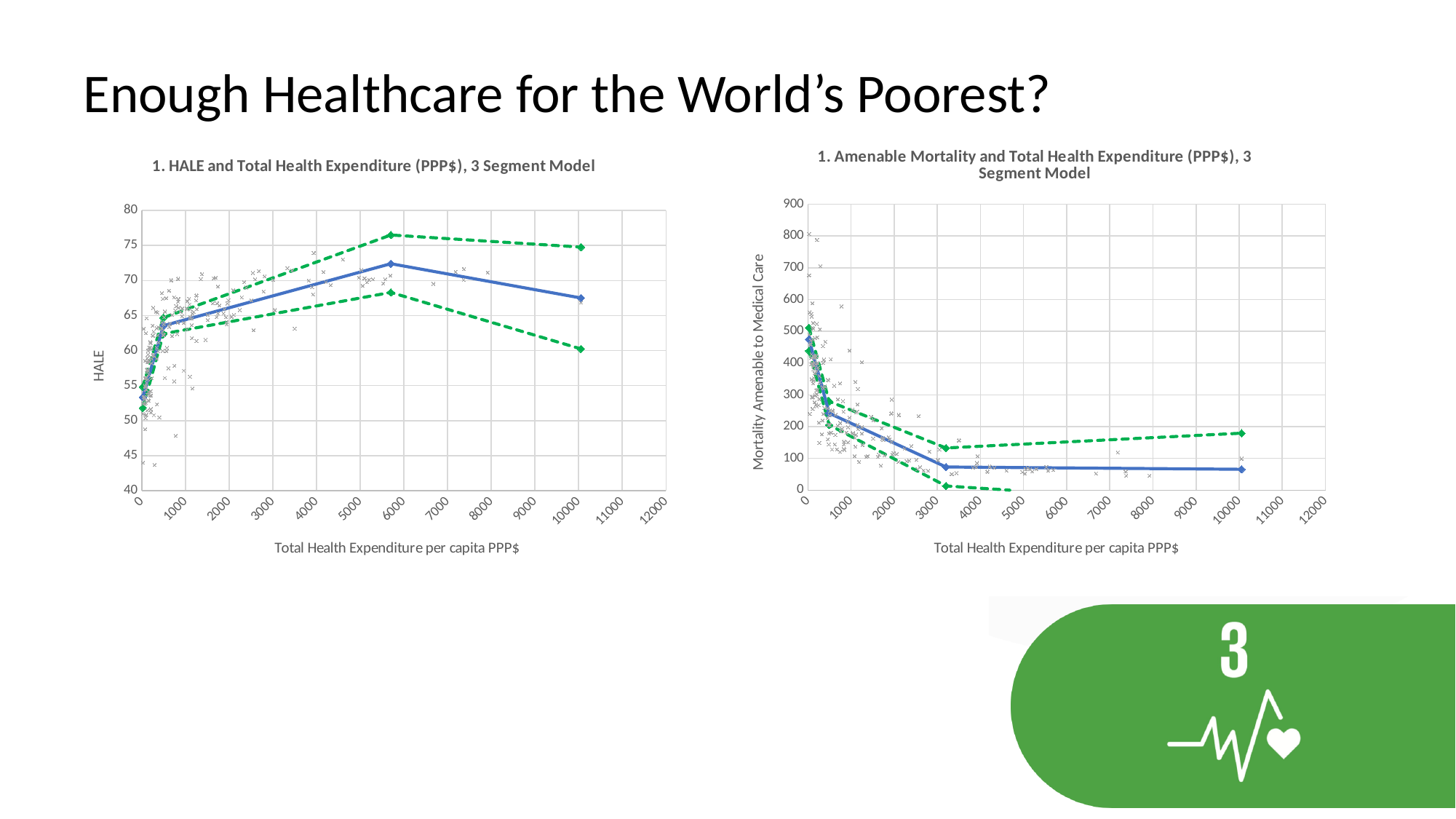
What is the title of the chart on the left? 1. HALE and Total Health Expenditure (PPP$), 3 Segment Model In the right chart (Amenable Mortality and Total Health Expenditure), does the solid blue line rise or fall between 0 and 3000 PPP$? fall In the chart on the right, what is the label of the vertical axis? Mortality Amenable to Medical Care How many charts are shown on the slide? 2 In the left chart (HALE and Total Health Expenditure), is the solid blue line's value at its right-hand end near 10000 PPP$ greater or less than 70? less In the left chart (HALE and Total Health Expenditure), is the solid blue line's value at its peak near 6000 PPP$ greater or less than 70? greater In the left chart (HALE and Total Health Expenditure), does the solid blue line rise or fall between 6000 and 10000 PPP$? fall In the left chart (HALE and Total Health Expenditure), what is the largest tick value on the horizontal axis? 12000 In the right chart (Amenable Mortality and Total Health Expenditure), is the solid blue line's value at its right-hand end near 10000 PPP$ greater or less than 100? less In the right chart (Amenable Mortality and Total Health Expenditure), what is the highest value shown on the vertical axis? 900 In the left chart (HALE and Total Health Expenditure), what is the highest value shown on the vertical axis? 80